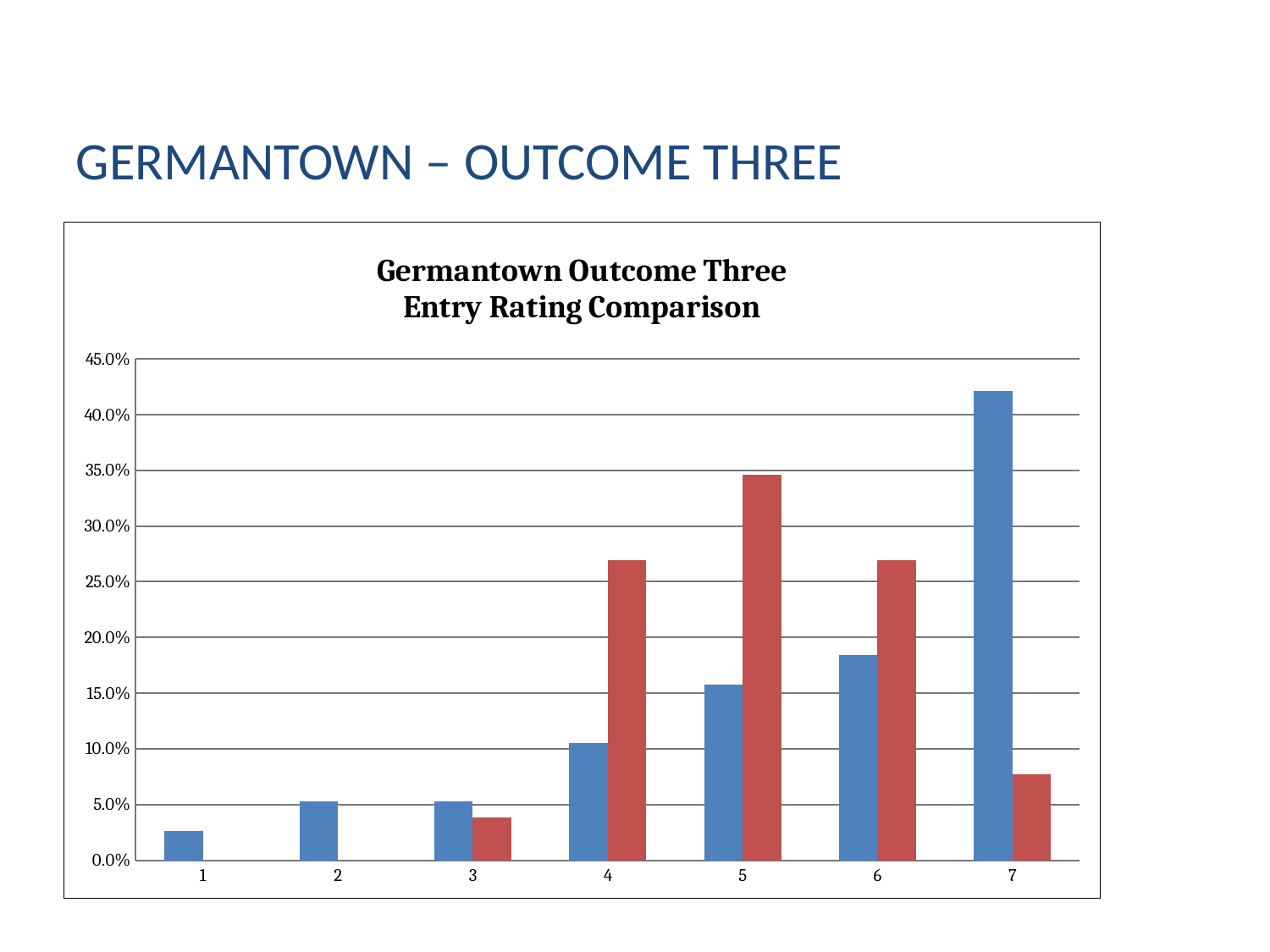
What is the title of the chart? Germantown Outcome Three Entry Rating Comparison Is the red bar for category 5 greater or less than 30.0%? greater For which category is the blue bar the highest? 7 For which category is the red bar the highest? 5 Do the blue bars generally rise or fall from category 1 to category 7? Rise How many categories are shown on the x axis of the chart? 7 For which category is the blue bar the lowest? 1 For category 4, which bar is larger, the blue bar or the red bar? The red bar Is the blue bar for category 4 greater or less than 15.0%? less What kind of chart is shown on the slide? Bar chart Is the red bar for category 7 greater or less than 10.0%? less